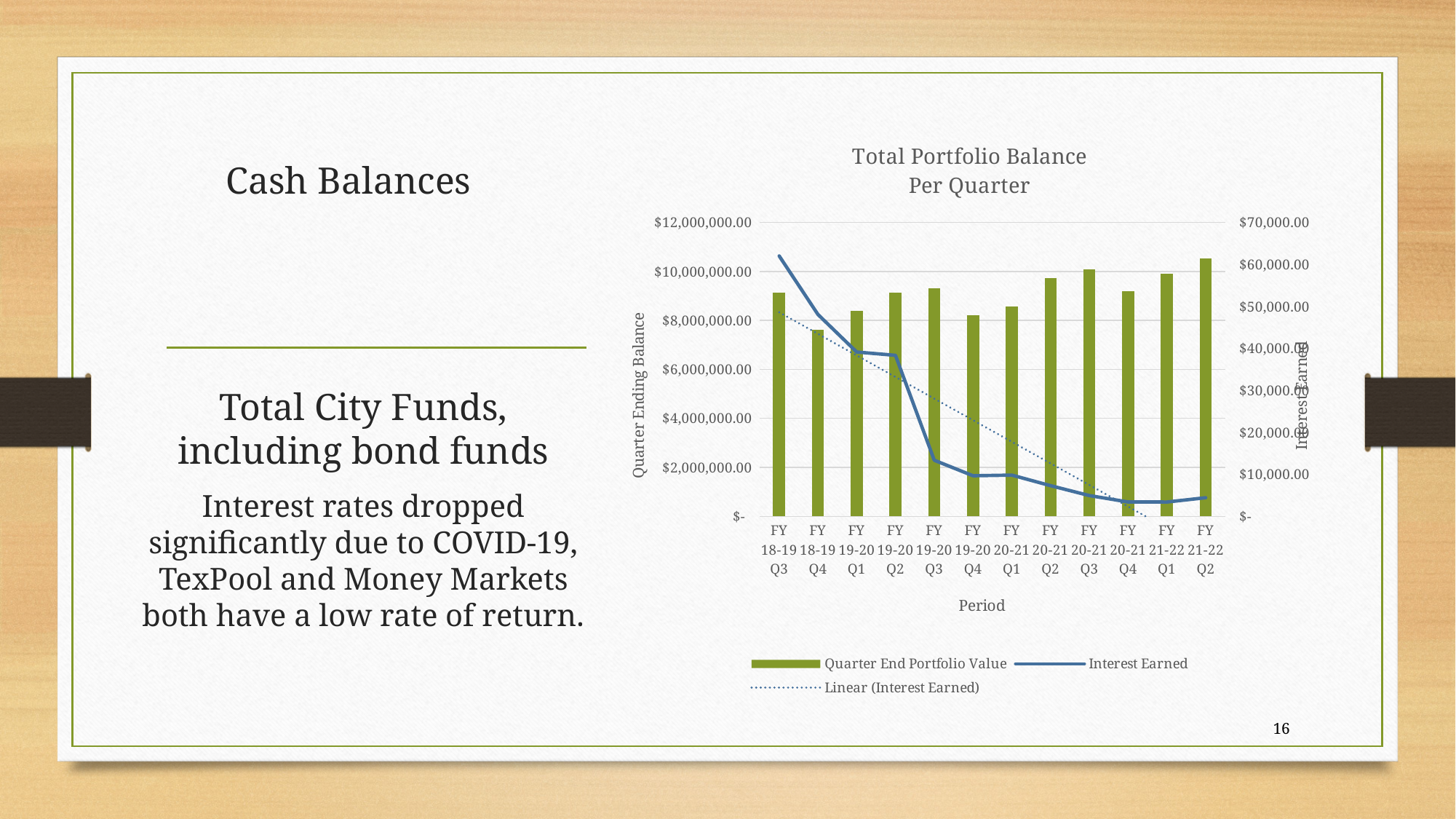
How many entries does the chart's legend list? 3 Which has the larger Quarter End Portfolio Value, FY 20-21 Q3 or FY 20-21 Q4? FY 20-21 Q3 Does the Interest Earned line generally rise or fall from FY 18-19 Q3 to FY 21-22 Q2? Fall What is the title of the chart on the slide? Total Portfolio Balance Per Quarter Is the Interest Earned for FY 19-20 Q3 greater or less than $20,000.00? less Is the Quarter End Portfolio Value for FY 21-22 Q2 greater or less than $10,000,000.00? greater Which period has the highest Interest Earned value? FY 18-19 Q3 What kind of chart is shown on the slide? Combination bar and line chart Which period has the lowest Quarter End Portfolio Value bar? FY 18-19 Q4 Is the Quarter End Portfolio Value for FY 18-19 Q4 greater or less than $8,000,000.00? less Which period has the highest Quarter End Portfolio Value bar? FY 21-22 Q2 How many periods (quarters) are shown on the x axis of the chart? 12